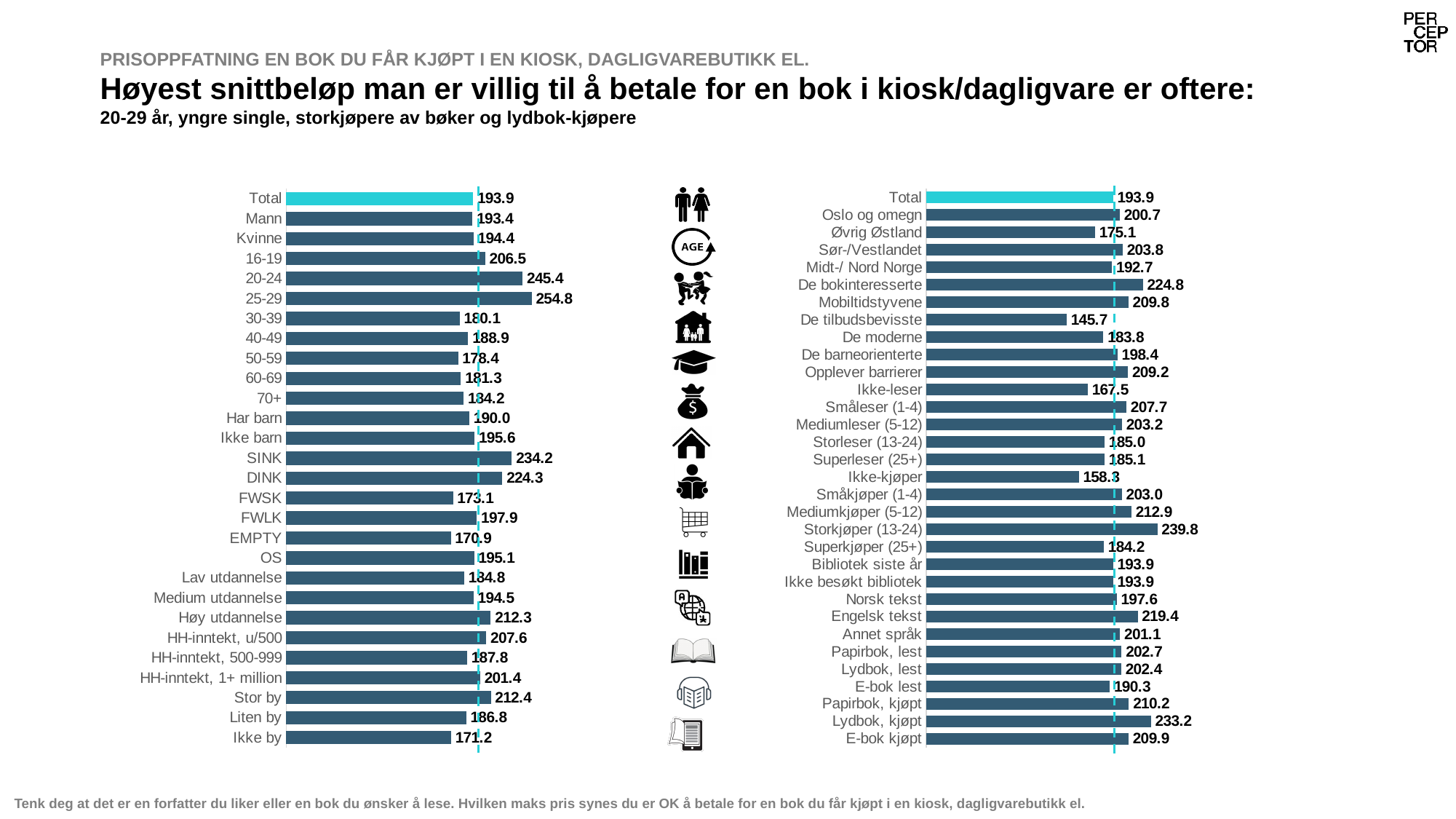
In the right chart, what is the value for De tilbudsbevisste? 145.7 In the left chart, what is the difference between the values for 20-24 and 30-39? 65.3 In the right chart, which is larger, the value for Lydbok, kjøpt or the value for Papirbok, kjøpt? Lydbok, kjøpt In the right chart, which category has the highest value? Storkjøper (13-24) How many bars does the left chart have? 28 What type of chart is the right chart? Bar chart In the left chart, what is the value for 25-29? 254.8 In the left chart, which category has the highest value? 25-29 In the left chart, which category has the lowest value? EMPTY In the right chart, what is the value for Storkjøper (13-24)? 239.8 In the right chart, which category has the lowest value? De tilbudsbevisste In the left chart, what is the value for SINK? 234.2